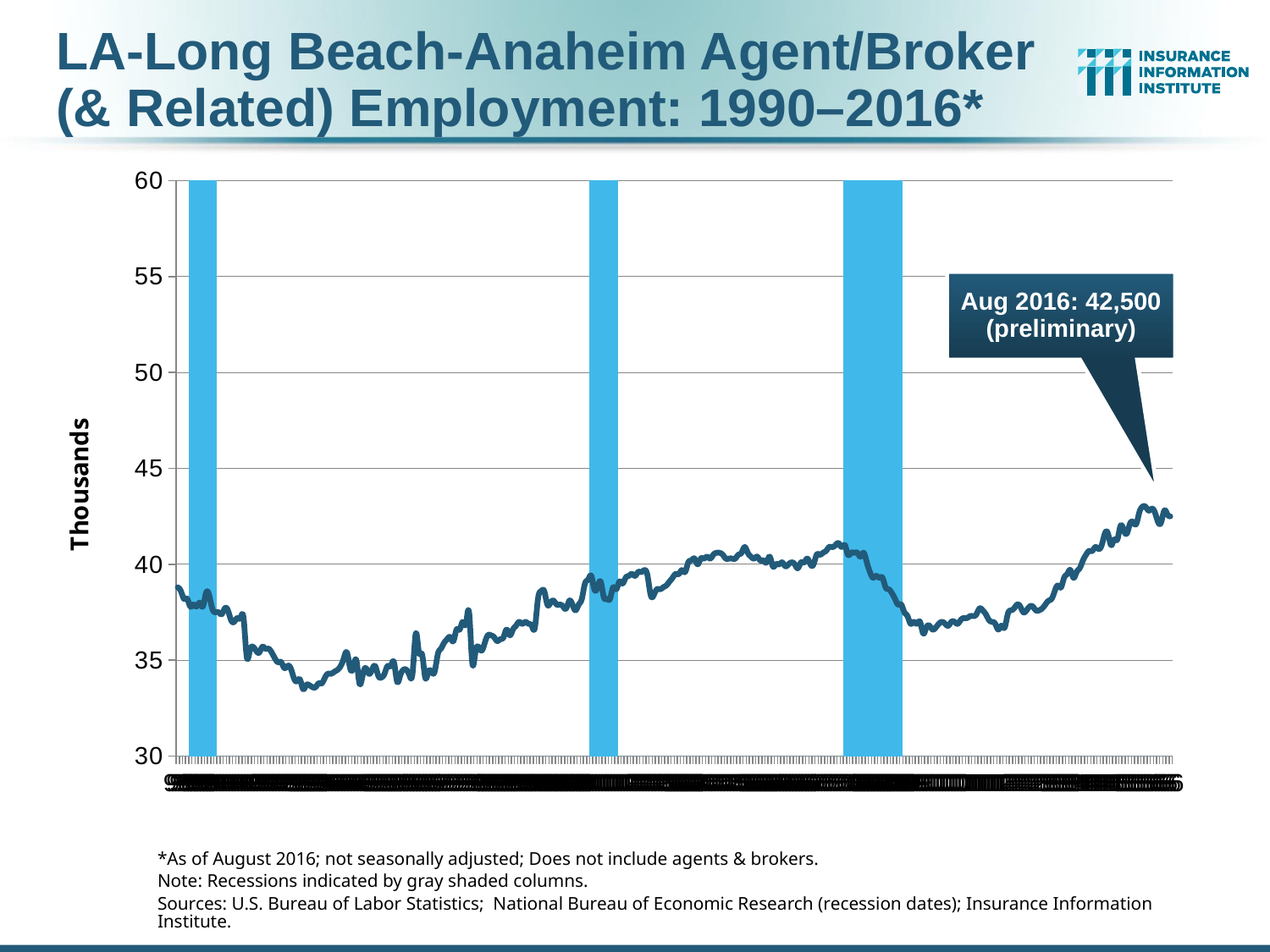
Is the highest point of the line greater or less than 45 on the vertical axis? less Does the line rise or fall over the final years leading up to Aug 2016? rise Is the Aug 2016 value greater or less than 40 on the vertical axis? greater Is the value at the end of the series (2016) higher or lower than at the start (1990)? higher What is the employment value labeled for Aug 2016? 42,500 (preliminary) What is the title of the chart? LA-Long Beach-Anaheim Agent/Broker (& Related) Employment: 1990–2016* How many shaded recession columns are shown on the chart? 3 Is the lowest point of the line greater or less than 35 on the vertical axis? less What is the label on the vertical axis? Thousands What kind of chart is shown on the slide? line chart What is the maximum value shown on the vertical axis? 60